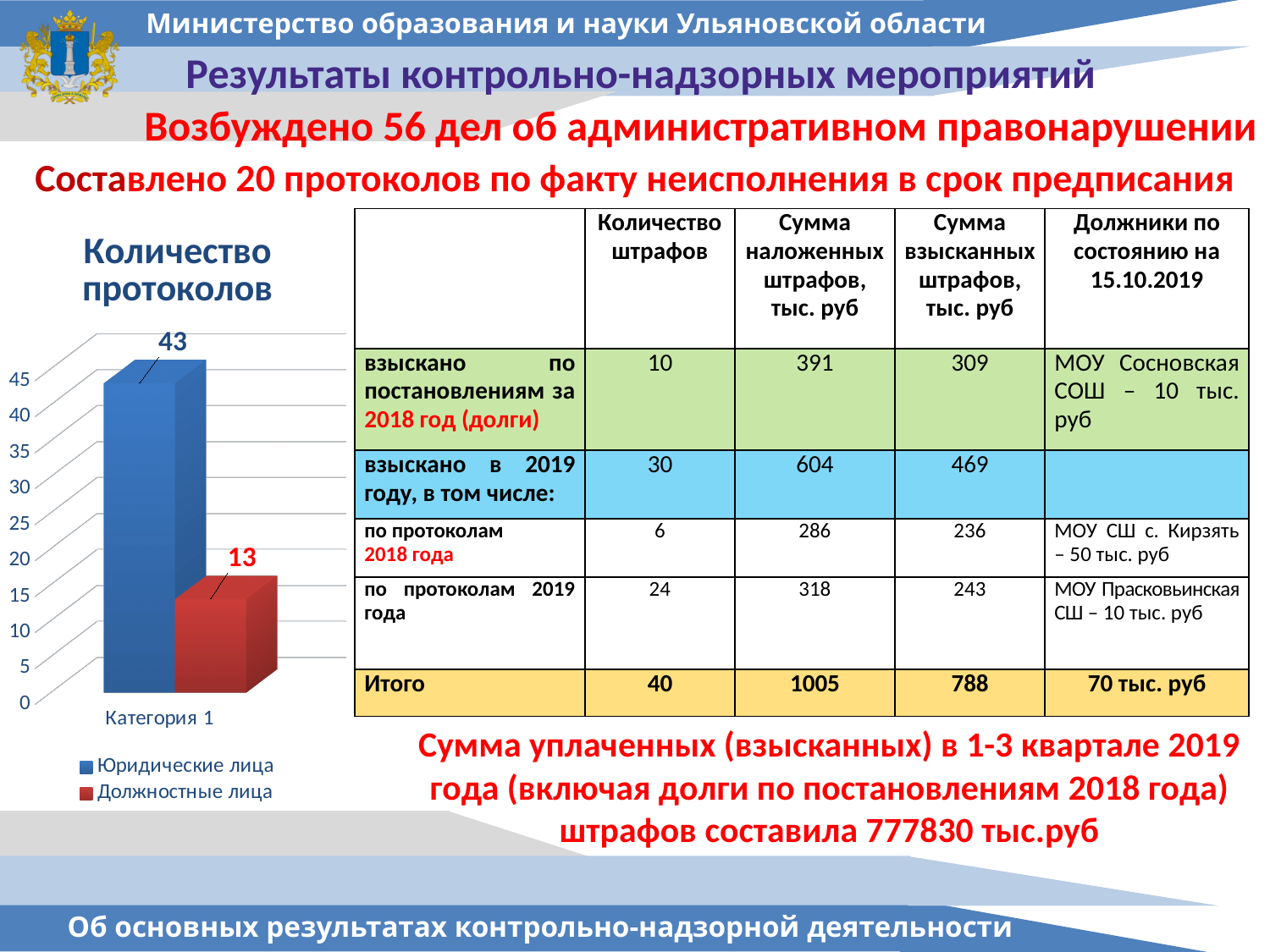
What kind of chart is "Количество протоколов"? bar chart Is the value for Должностные лица in the chart "Количество протоколов" greater or less than 15? less What is the difference between the values for Юридические лица and Должностные лица in the chart "Количество протоколов"? 30 What is the title of the chart on the left of the slide? Количество протоколов In the chart "Количество протоколов", which is larger: the value for Юридические лица or for Должностные лица? Юридические лица What is the value for Юридические лица in the chart "Количество протоколов"? 43 Which series has the highest value in the chart "Количество протоколов"? Юридические лица Is the value for Юридические лица in the chart "Количество протоколов" greater or less than 40? greater What colour is the bar for Должностные лица in the chart "Количество протоколов"? red What is the value for Должностные лица in the chart "Количество протоколов"? 13 How many series does the legend of the chart "Количество протоколов" list? 2 Which series has the lowest value in the chart "Количество протоколов"? Должностные лица